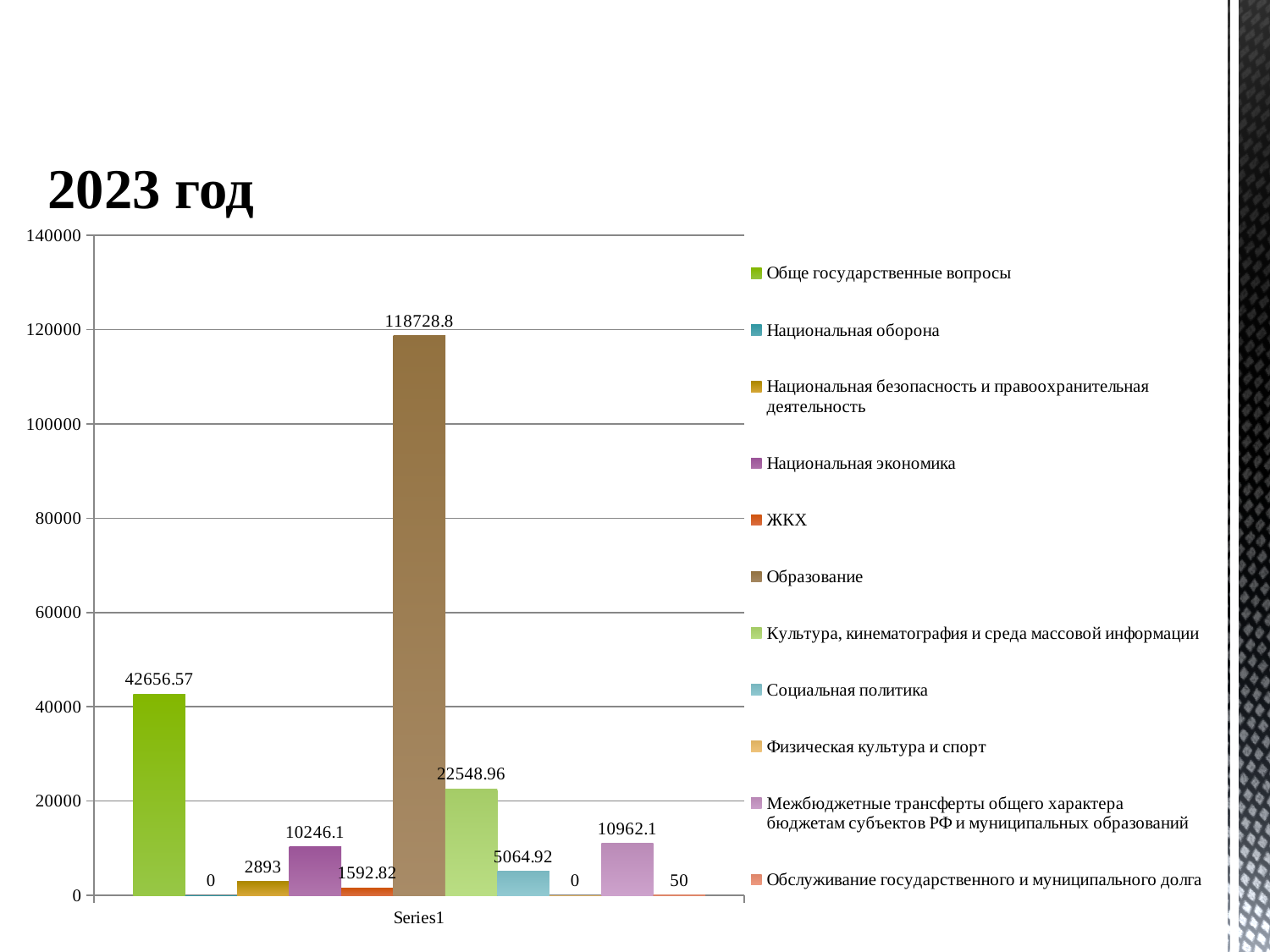
Is the value for Культура, кинематография и среда массовой информации greater or less than 20000? greater What kind of chart is shown on the slide? bar chart What is the title of the slide above the chart? 2023 год What is the value for Обслуживание государственного и муниципального долга? 50 What is the value for Социальная политика? 5064.92 How many series does the legend list? 11 Which is larger, the value for Национальная экономика or the value for Межбюджетные трансферты общего характера бюджетам субъектов РФ и муниципальных образований? Межбюджетные трансферты общего характера бюджетам субъектов РФ и муниципальных образований What is the value for Обще государственные вопросы? 42656.57 What is the value for Образование? 118728.8 What is the value for ЖКХ? 1592.82 Which legend entry has the highest value? Образование What is the difference between the values for Образование and Обще государственные вопросы? 76072.23